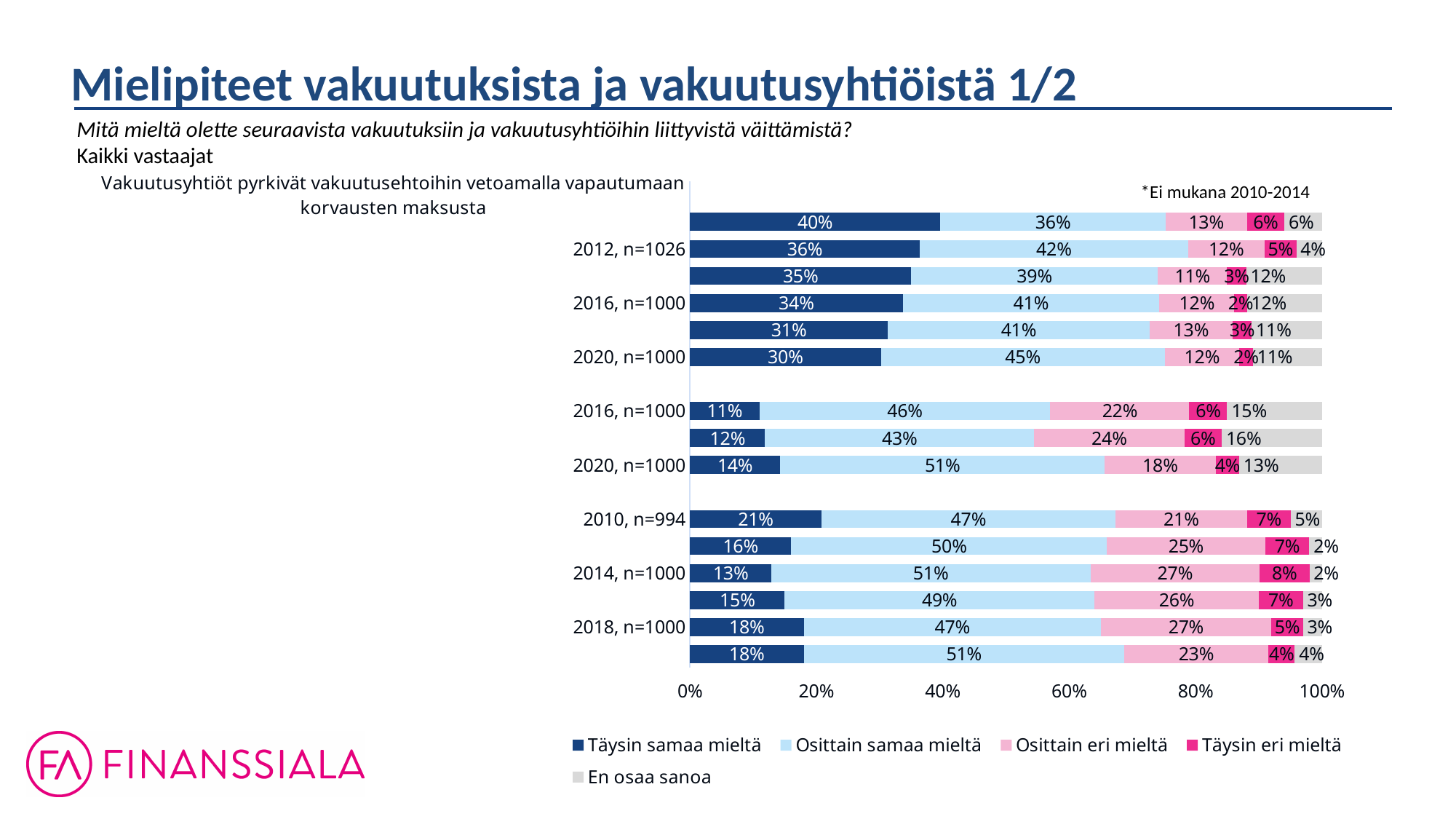
In the bottom group of bars, which of the labelled years (2010, 2014, 2018) has the highest "Täysin samaa mieltä" share? 2010, n=994 For the statement "Vakuutusyhtiöt pyrkivät vakuutusehtoihin vetoamalla vapautumaan korvausten maksusta", what is the "Täysin samaa mieltä" share for 2012, n=1026? 36% In the middle group of bars, which year has the larger "Osittain samaa mieltä" share: 2016, n=1000 or 2020, n=1000? 2020, n=1000 For the statement "Vakuutusyhtiöt pyrkivät vakuutusehtoihin vetoamalla vapautumaan korvausten maksusta", does the "Täysin samaa mieltä" share rise or fall from 2012 to 2016 to 2020? Fall For the statement "Vakuutusyhtiöt pyrkivät vakuutusehtoihin vetoamalla vapautumaan korvausten maksusta", by how many percentage points does the "Täysin samaa mieltä" share for 2012, n=1026 exceed that for 2020, n=1000? 6 percentage points In the bottom group of bars, what is the "En osaa sanoa" share for 2010, n=994? 5% What kind of chart is shown on the slide? Stacked bar chart In the bottom group of bars, what is the "Täysin eri mieltä" share for 2014, n=1000? 8% What does the footnote in the top right of the chart say? *Ei mukana 2010-2014 In the middle group of bars, what is the "Osittain eri mieltä" share for 2016, n=1000? 22% For the statement "Vakuutusyhtiöt pyrkivät vakuutusehtoihin vetoamalla vapautumaan korvausten maksusta", what is the "Osittain samaa mieltä" share for 2020, n=1000? 45% How many series does the chart legend list? 5